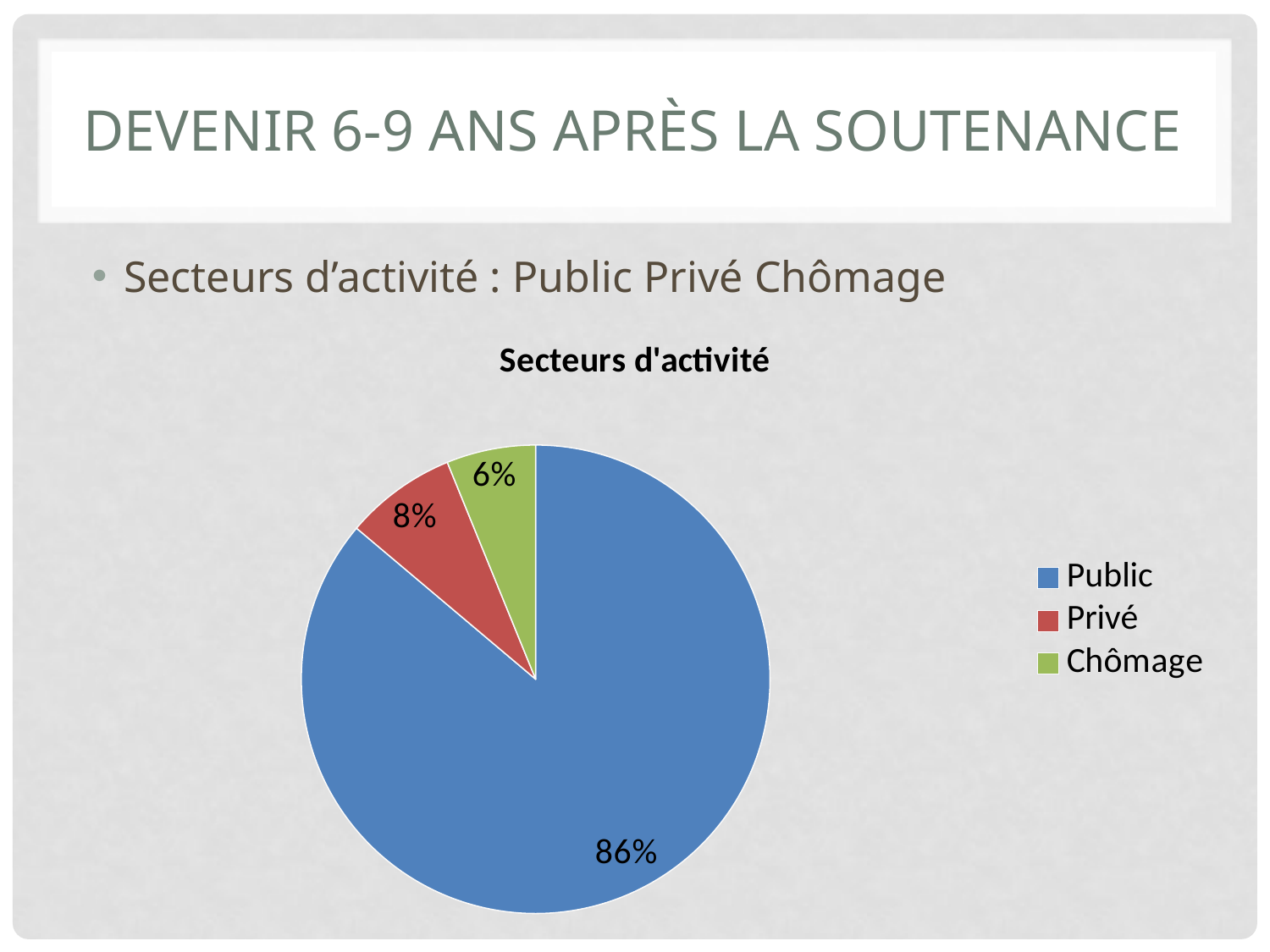
What is the difference in percentage points between the Public and Privé slices? 78 What share of the pie does Privé represent? 8% How many categories are shown in the pie chart? 3 What share of the pie does Chômage represent? 6% Which is larger, the Privé slice or the Chômage slice? Privé What share of the pie does Public represent? 86% Which category has the largest slice of the pie? Public What is the difference in percentage points between the Privé and Chômage slices? 2 What colour is the Chômage slice in the pie chart? Green What is the title of the chart? Secteurs d'activité What kind of chart is shown on the slide? Pie chart Which category has the smallest slice of the pie? Chômage